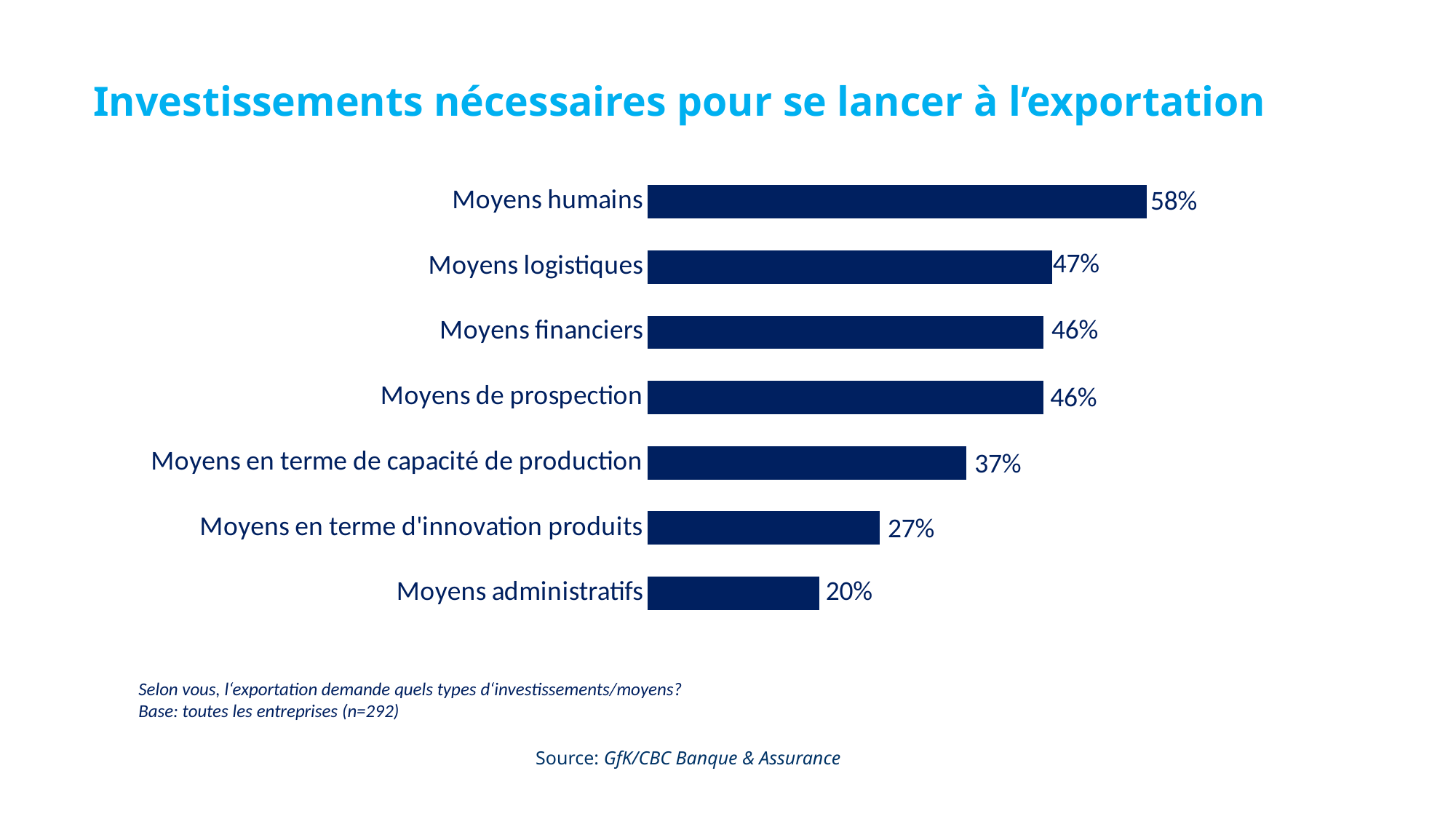
What is the value for Moyens humains? 58% What is the difference between the values for Moyens logistiques and Moyens en terme d'innovation produits? 20% What is the difference between the values for Moyens humains and Moyens administratifs? 38% How many categories are shown in the chart? 7 What is the title of the chart? Investissements nécessaires pour se lancer à l'exportation What is the value for Moyens logistiques? 47% What is the value for Moyens administratifs? 20% What is the value for Moyens en terme de capacité de production? 37% Which category has the lowest value? Moyens administratifs What kind of chart is shown on the slide? Bar chart Which is larger, the value for Moyens financiers or the value for Moyens en terme d'innovation produits? Moyens financiers Which category has the highest value? Moyens humains